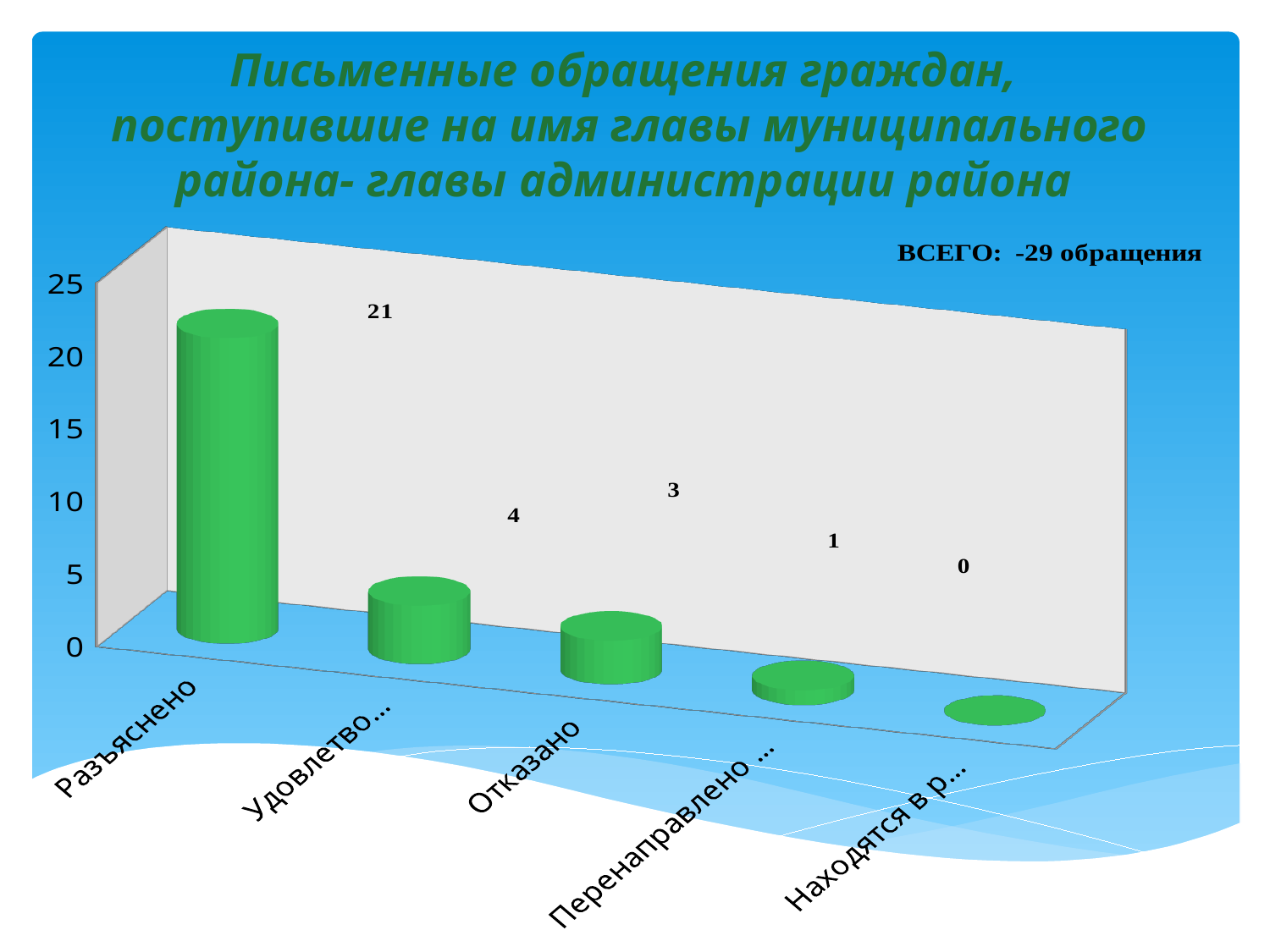
What is the value for the second category ("Удовлетво...")? 4 What is the value for the category "Отказано"? 3 Which is larger, the value for "Отказано" or the value for the fourth category ("Перенаправлено ...")? Отказано What is the value for the category "Разъяснено"? 21 Which category has the lowest value? Находятся в р... Do the values rise or fall from left to right along the x axis? fall Which category has the highest value? Разъяснено What type of chart is shown on the slide? bar chart How many categories are shown on the x axis of the chart? 5 What total number of appeals (ВСЕГО) is stated on the chart? 29 обращения What is the difference between the values for "Разъяснено" and "Отказано"? 18 What is the value for the last category ("Находятся в р...")? 0